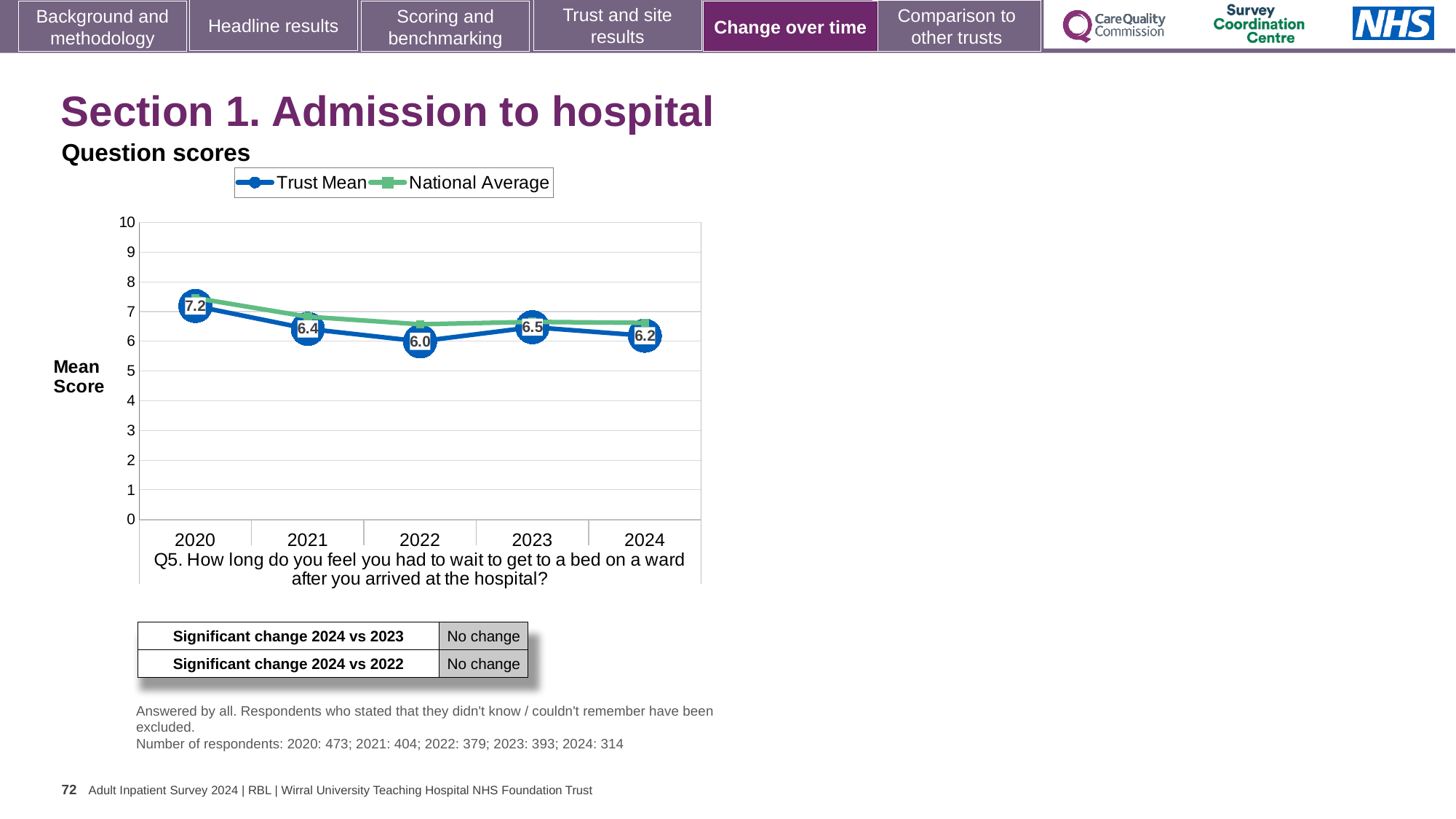
Which is larger, the Trust Mean score in 2021 or in 2023? 2023 What is the difference between the Trust Mean score in 2020 and in 2024? 1.0 In which year is the Trust Mean score lowest? 2022 Is the National Average value for 2022 greater or less than 6? greater In which year is the Trust Mean score highest? 2020 What is the Trust Mean score for 2022? 6.0 How many series does the legend list? 2 What kind of chart is shown on the slide? Line chart Is the National Average value for 2020 greater or less than 7? greater What is the Trust Mean score for 2024? 6.2 What is the Trust Mean score for 2020? 7.2 How many years are plotted on the x axis? 5